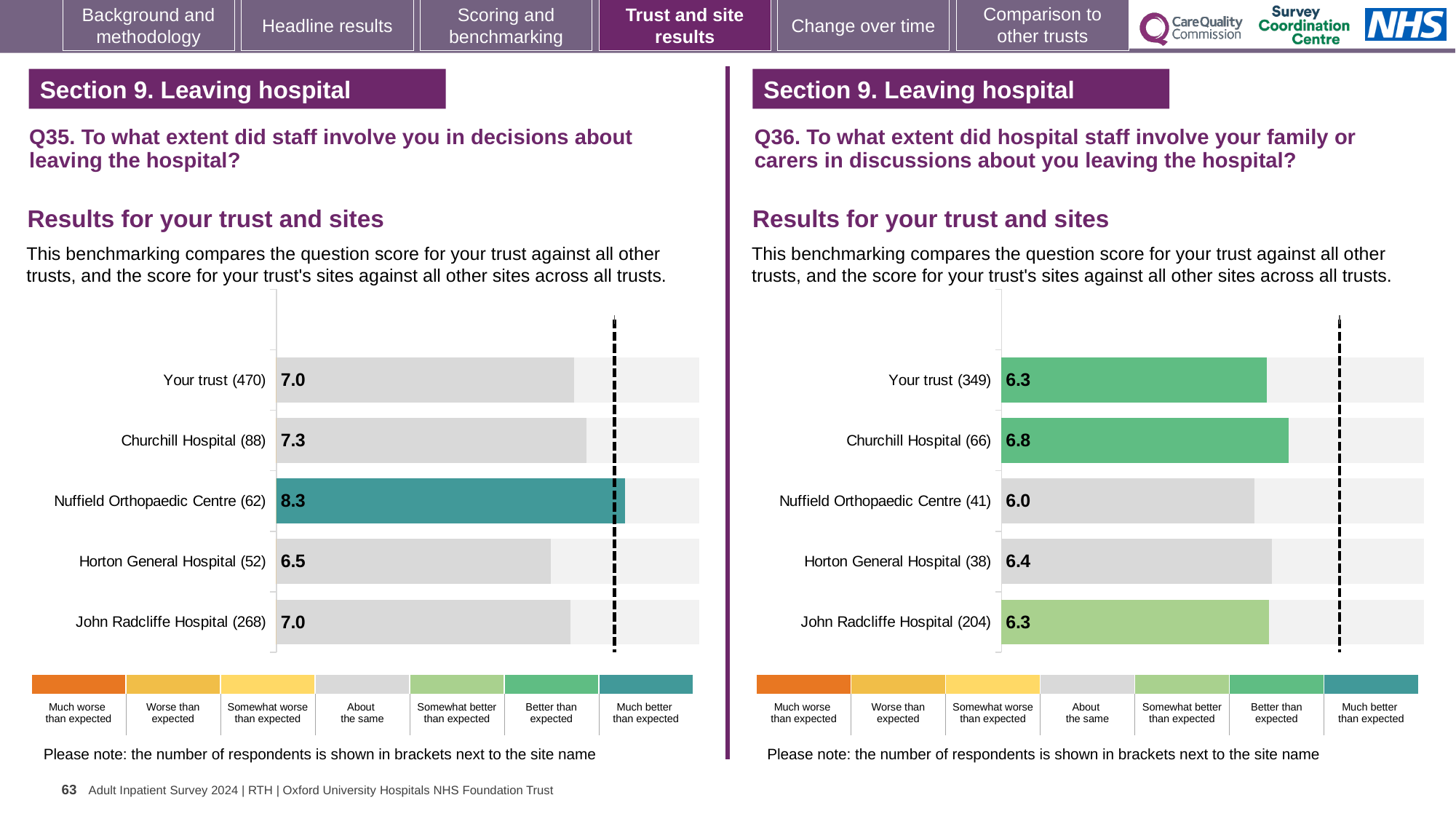
In the Q35 chart on the left, what is the score for Nuffield Orthopaedic Centre? 8.3 In the Q35 chart on the left, what is the score for Horton General Hospital? 6.5 In the Q35 chart on the left, what is the difference between the scores for Nuffield Orthopaedic Centre and Your trust? 1.3 In the Q35 chart on the left, which site has the highest score? Nuffield Orthopaedic Centre What kind of chart is used for the Q36 results on the right? Bar chart In the Q36 chart on the right, which site has the lowest score? Nuffield Orthopaedic Centre In the Q36 chart on the right, what is the score for Your trust? 6.3 In the Q36 chart on the right, what is the difference between the scores for Churchill Hospital and Nuffield Orthopaedic Centre? 0.8 How many bars are plotted in the Q35 chart on the left? 5 In the Q35 chart on the left, which site has the lowest score? Horton General Hospital In the Q36 chart on the right, which is larger, the score for Churchill Hospital or Horton General Hospital? Churchill Hospital In the Q36 chart on the right, what is the score for Churchill Hospital? 6.8